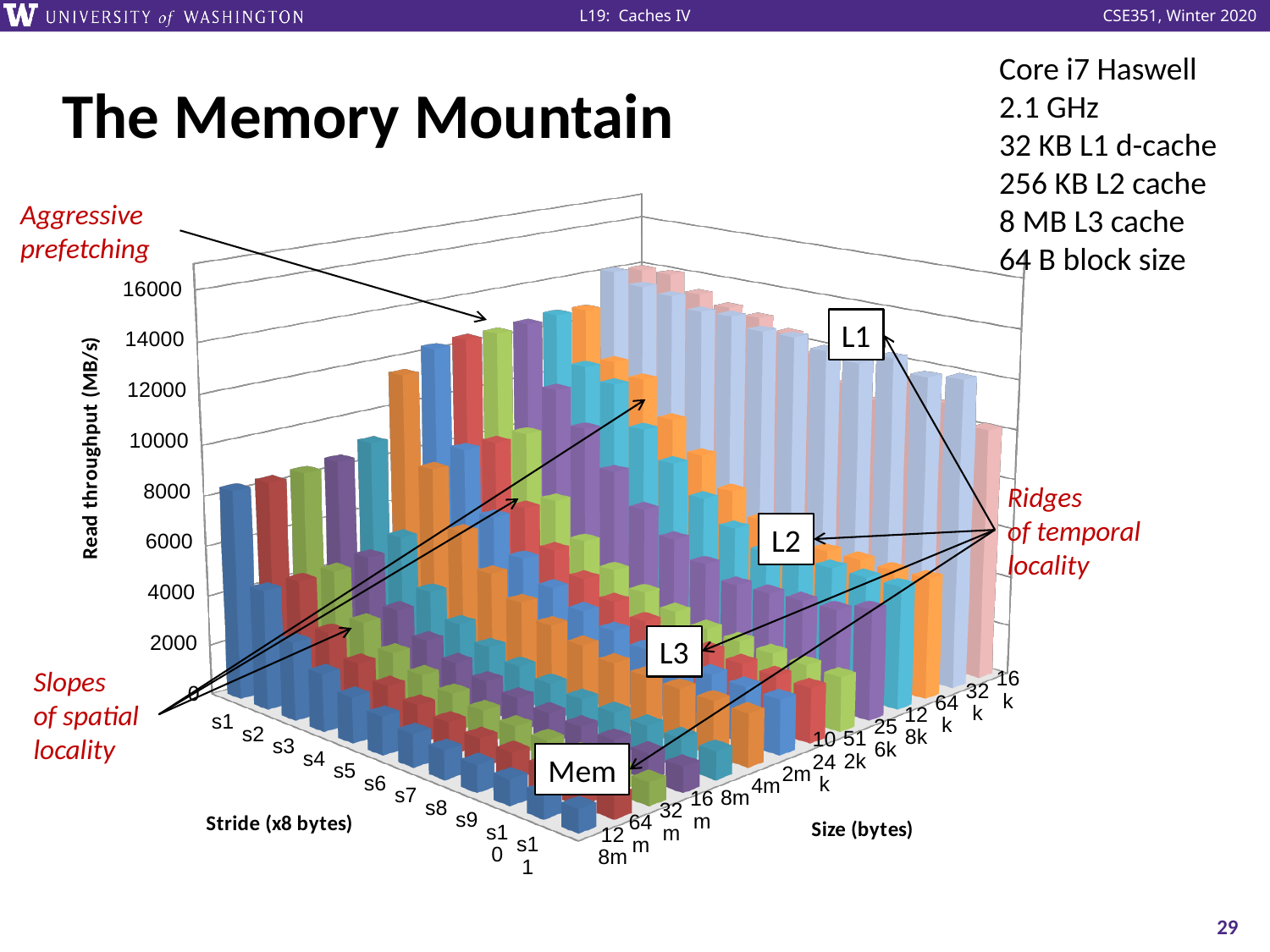
For size 128m, does read throughput rise or fall as the stride goes from s1 to s11? fall For stride s1, does read throughput rise or fall as the size goes from 128m toward 16k? rise What kind of chart is shown on the slide? 3D bar chart Is the read throughput for stride s1 at size 16k greater or less than 12000? greater Is the read throughput for stride s1 at size 16k greater or less than the read throughput for stride s1 at size 128m? greater What is the highest tick value shown on the read throughput axis? 16000 How many stride categories (s1, s2, ...) are shown along the stride axis? 11 Is the read throughput for stride s1 at size 128m greater or less than 4000? greater What is the title of the vertical axis of the chart? Read throughput (MB/s) What are the titles of the two horizontal axes of the chart? Stride (x8 bytes) and Size (bytes) How many size categories are shown along the size axis? 14